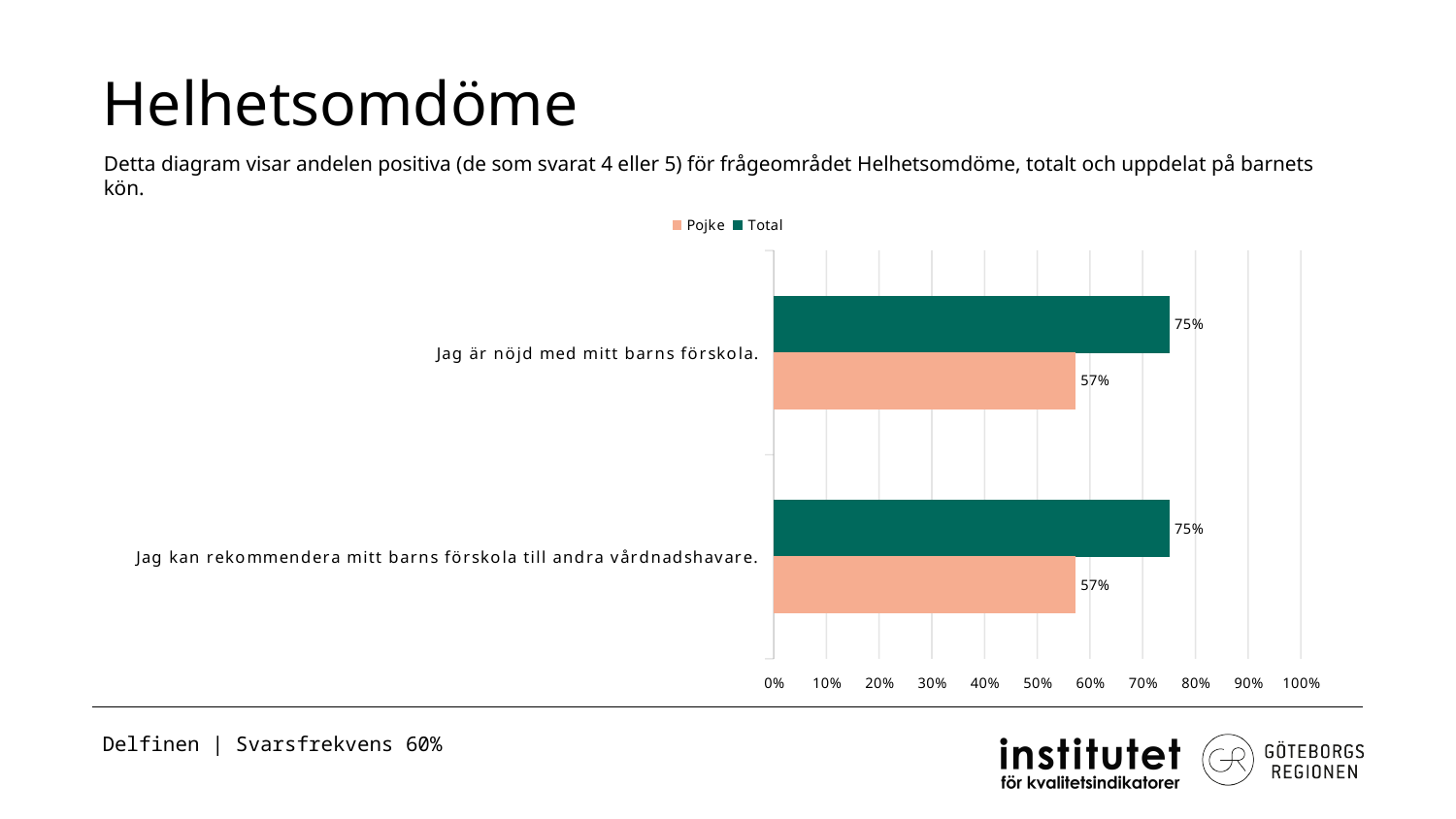
What is the Pojke value for "Jag är nöjd med mitt barns förskola."? 57% Which series is shown in dark green in the chart? Total What is the Pojke value for "Jag kan rekommendera mitt barns förskola till andra vårdnadshavare."? 57% For "Jag kan rekommendera mitt barns förskola till andra vårdnadshavare.", which is larger, the Pojke value or the Total value? Total How many series does the legend list? 2 What kind of chart is shown on the slide? Bar chart Is the Pojke value for "Jag är nöjd med mitt barns förskola." greater or less than 60%? less What is the Total value for "Jag är nöjd med mitt barns förskola."? 75% What is the difference between the Total and Pojke values for "Jag är nöjd med mitt barns förskola."? 18 percentage points How many categories (statements) are shown in the chart? 2 Is the Total value for "Jag kan rekommendera mitt barns förskola till andra vårdnadshavare." greater or less than 70%? greater What is the Total value for "Jag kan rekommendera mitt barns förskola till andra vårdnadshavare."? 75%